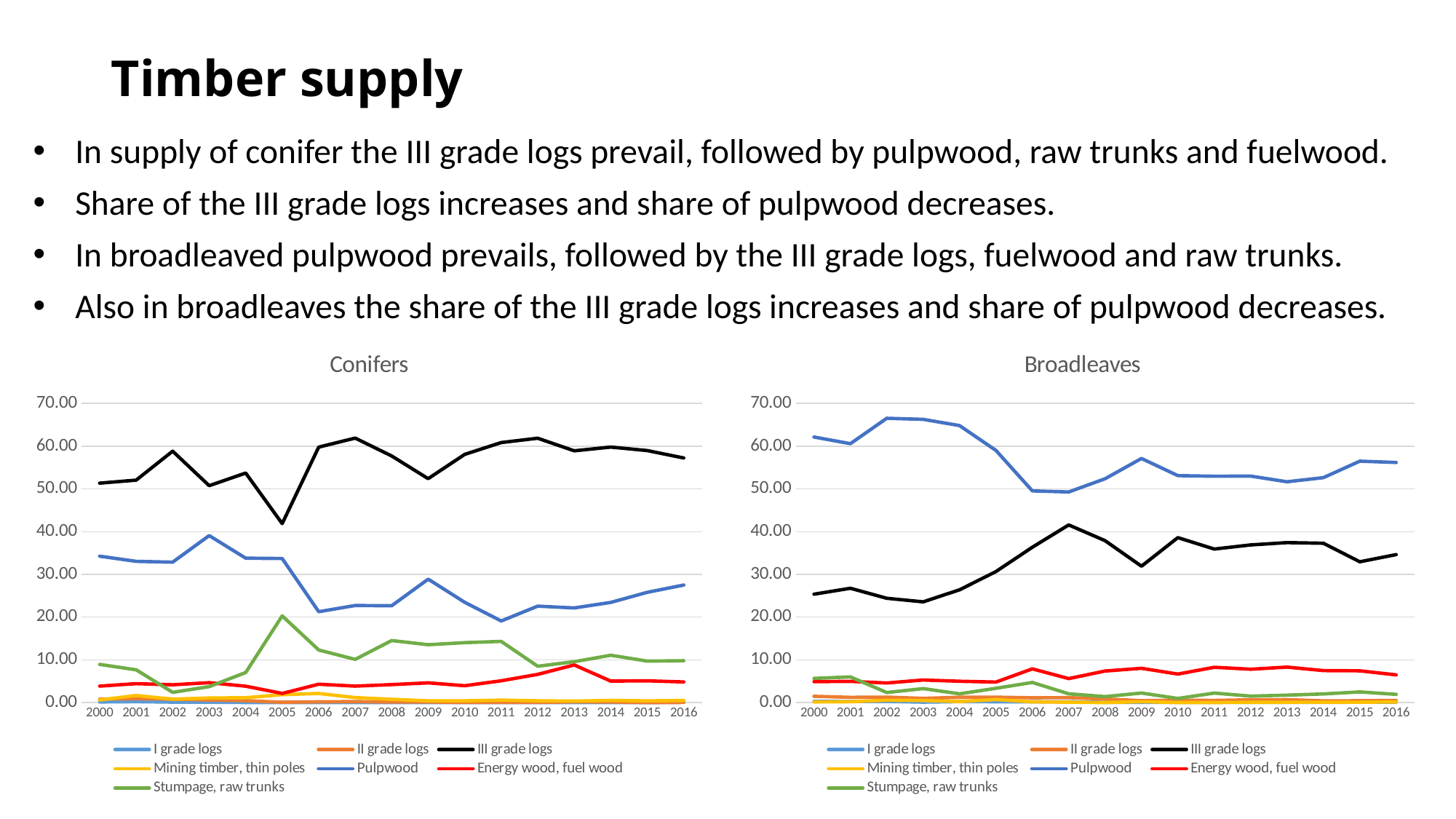
How many series does the legend of the Broadleaves chart list? 7 In the Conifers chart, in which year is III grade logs at its lowest? 2005 In the Broadleaves chart, is the value for Pulpwood in 2002 greater or less than 60.00? greater In the Conifers chart, which series has the highest value in 2010? III grade logs How many years are shown on the x axis of the Conifers chart? 17 In the Broadleaves chart, which is larger in 2000: Pulpwood or III grade logs? Pulpwood What kind of chart is the Conifers chart? line chart In the Broadleaves chart, is the value for III grade logs in 2000 greater or less than 30.00? less In the Conifers chart, is the value for Stumpage, raw trunks in 2005 greater or less than 10.00? greater In the Broadleaves chart, in which year is III grade logs at its highest? 2007 In the Broadleaves chart, does the III grade logs line rise or fall from 2003 to 2007? rise